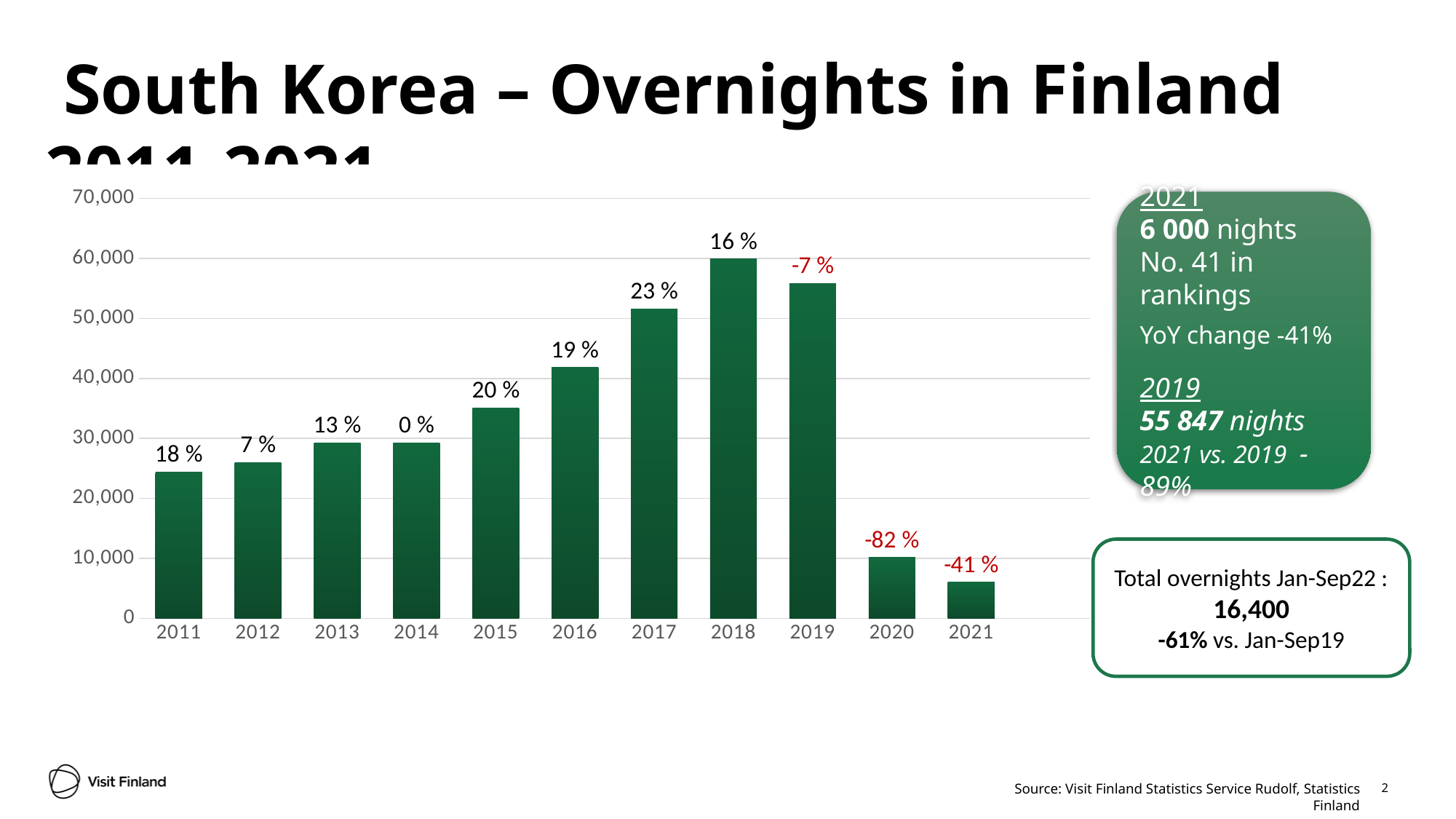
Which year has the highest bar (most overnights)? 2018 What percentage label is shown above the 2017 bar? 23 % What kind of chart is shown on the slide? bar chart What percentage label is shown above the 2014 bar? 0 % Is the value for 2020 greater or less than 20,000? less Which year has a taller bar, 2016 or 2013? 2016 Is the value for 2018 greater or less than 50,000? greater What percentage label is shown above the 2011 bar? 18 % Do the bar values rise or fall from 2011 to 2018? rise Which year has the lowest bar (fewest overnights)? 2021 How many years (bars) are plotted on the chart? 11 What percentage label is shown above the 2020 bar? -82 %